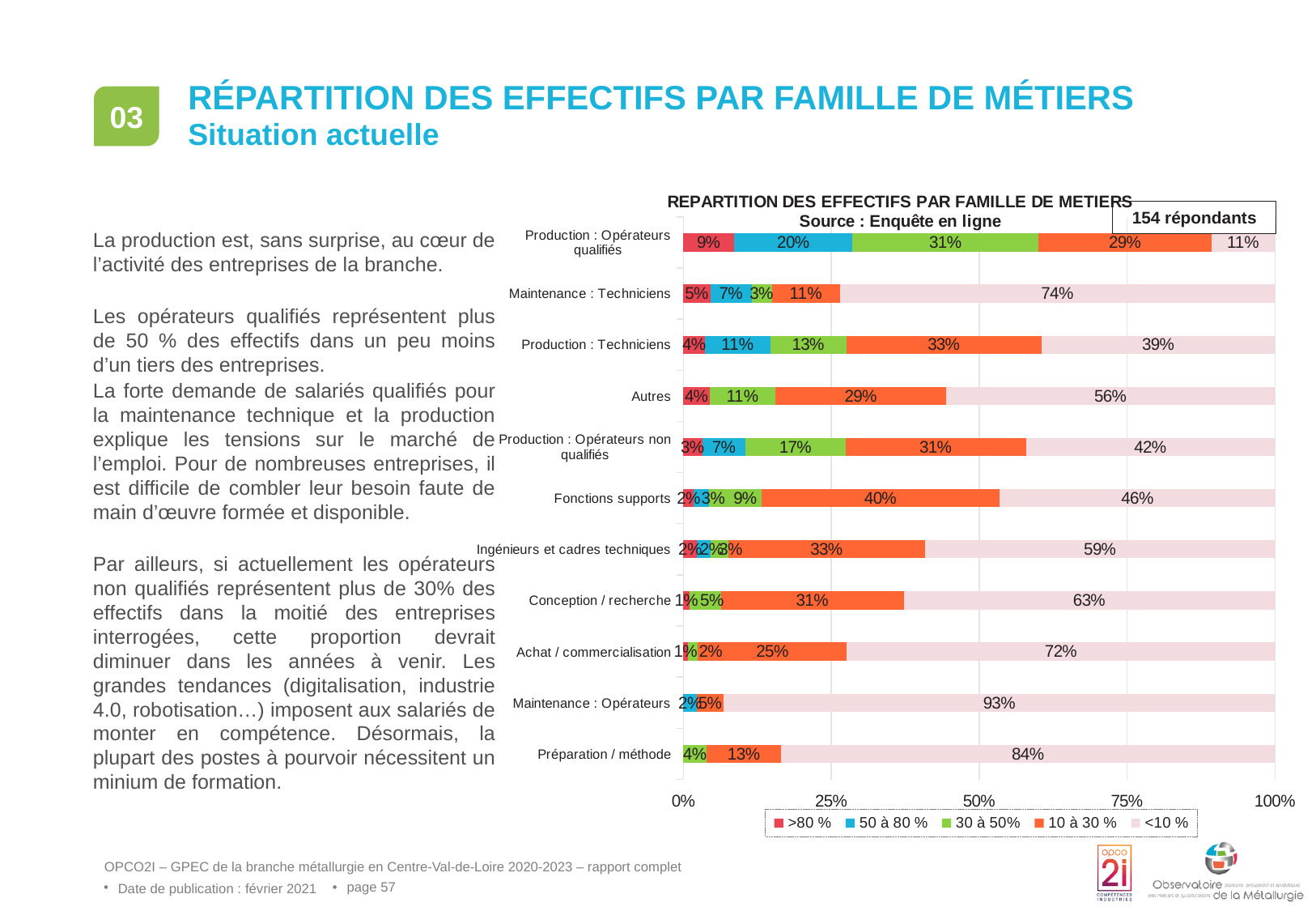
Which job family has the largest '<10 %' segment? Maintenance : Opérateurs How many job families (categories) are plotted in the chart? 11 What is the value of the '<10 %' segment for 'Maintenance : Opérateurs'? 93% What is the difference between the '<10 %' values for 'Préparation / méthode' and 'Production : Techniciens'? 45 percentage points How many series does the chart legend list? 5 What is the value of the '>80 %' segment for 'Production : Opérateurs qualifiés'? 9% Which has the larger '10 à 30 %' segment: 'Production : Techniciens' or 'Autres'? Production : Techniciens How many respondents does the chart indicate? 154 répondants What kind of chart is shown on the slide? Stacked bar chart What is the value of the '10 à 30 %' segment for 'Fonctions supports'? 40% Which job family has the smallest '<10 %' segment? Production : Opérateurs qualifiés What is the value of the '30 à 50%' segment for 'Production : Opérateurs qualifiés'? 31%